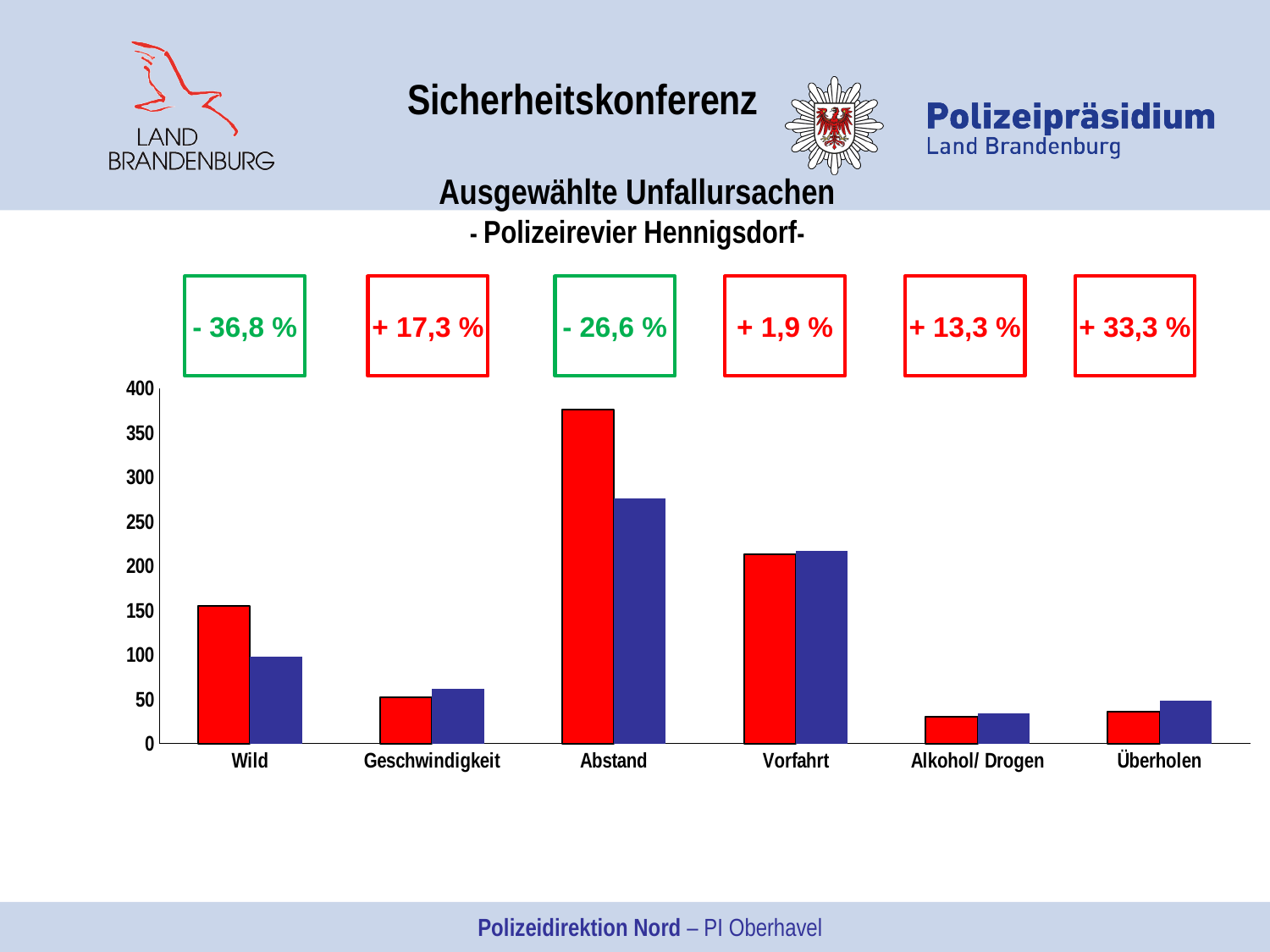
Which category has the shortest red bar in the chart? Alkohol/ Drogen For the category Wild, which bar is taller, the red one or the blue one? the red one Which category has the tallest bar in the chart? Abstand Is the blue bar for Wild greater or less than 150? less Is the red bar for Vorfahrt greater or less than 200? greater Is the blue bar for Abstand greater or less than 300? less What kind of chart is shown on the slide? bar chart How many categories are shown on the x axis of the chart? 6 What percentage change is shown in the box above the category Überholen? + 33,3 % What percentage change is shown in the box above the category Wild? - 36,8 %